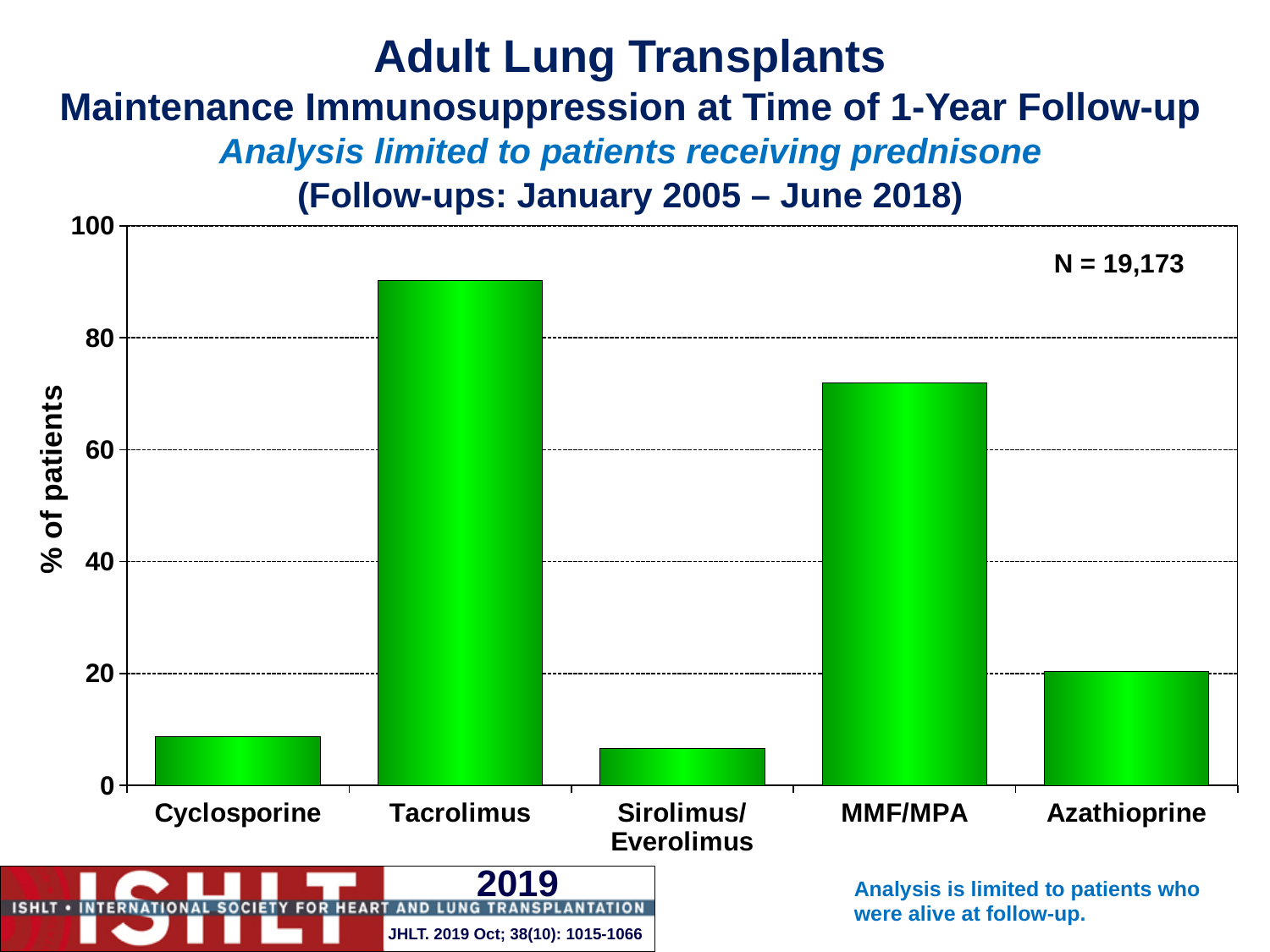
Is the value for Sirolimus/Everolimus greater or less than 20? less Which drug has the highest percentage of patients in the chart? Tacrolimus Is the value for MMF/MPA greater or less than 80? less What kind of chart is shown on the slide? bar chart How many categories (drugs) are shown on the x axis of the chart? 5 What is the N value shown on the chart? N = 19,173 What is the label on the y axis of the chart? % of patients Is the value for MMF/MPA greater or less than 60? greater Which has a higher percentage of patients, Azathioprine or Cyclosporine? Azathioprine Which has a higher percentage of patients, Tacrolimus or MMF/MPA? Tacrolimus